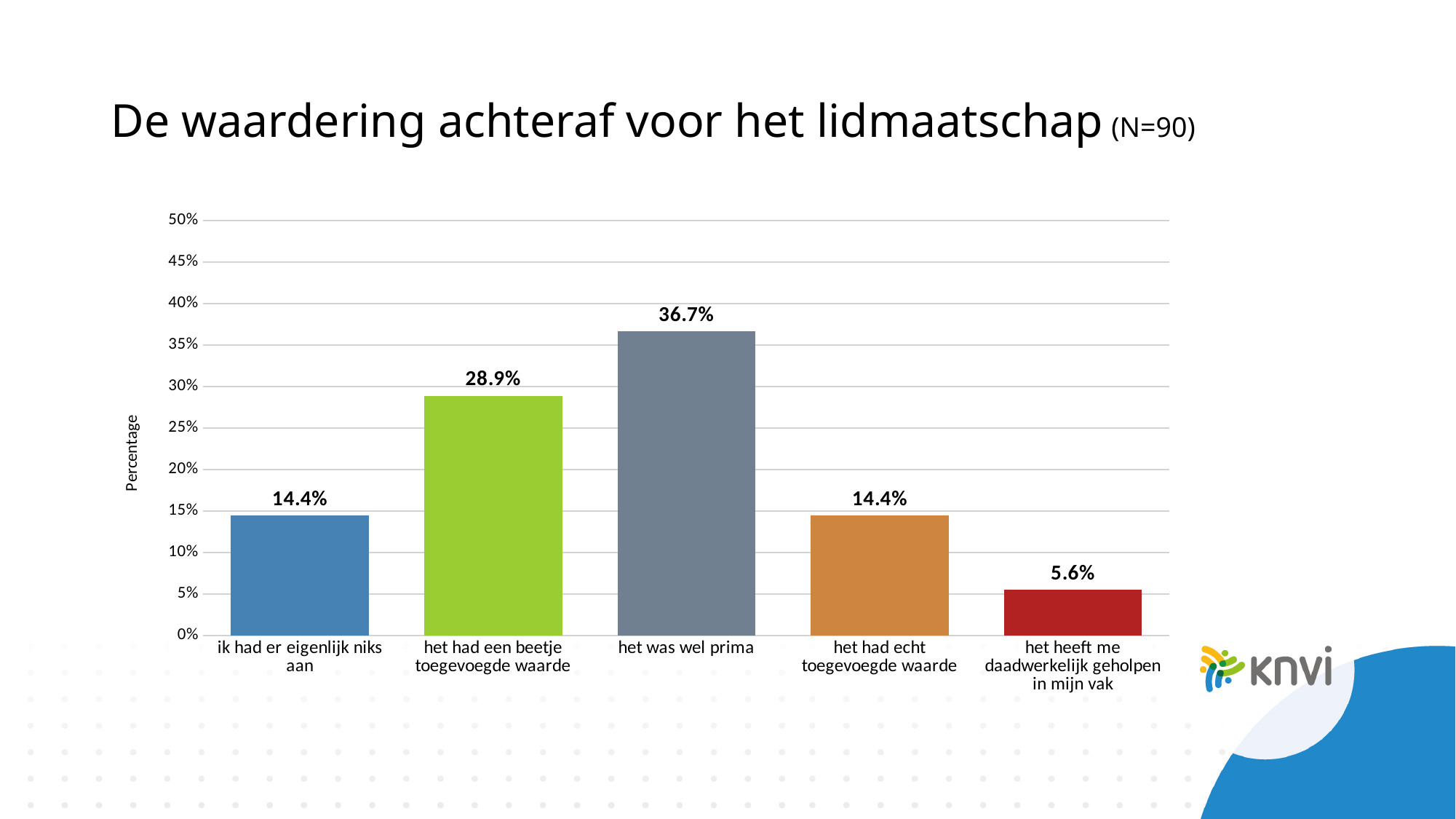
How many categories are shown on the x axis? 5 What percentage is shown for 'het heeft me daadwerkelijk geholpen in mijn vak'? 5.6% What percentage is shown for 'ik had er eigenlijk niks aan'? 14.4% What percentage is shown for 'het had een beetje toegevoegde waarde'? 28.9% Which is larger: the value for 'het had echt toegevoegde waarde' or the value for 'het heeft me daadwerkelijk geholpen in mijn vak'? het had echt toegevoegde waarde Which category has the lowest percentage? het heeft me daadwerkelijk geholpen in mijn vak Which category has the highest percentage? het was wel prima What is the difference in percentage points between 'het was wel prima' and 'het had een beetje toegevoegde waarde'? 7.8 What is the label of the y axis? Percentage What sample size (N) is given in the slide title? 90 What percentage is shown for 'het was wel prima'? 36.7% What kind of chart is shown on the slide? bar chart